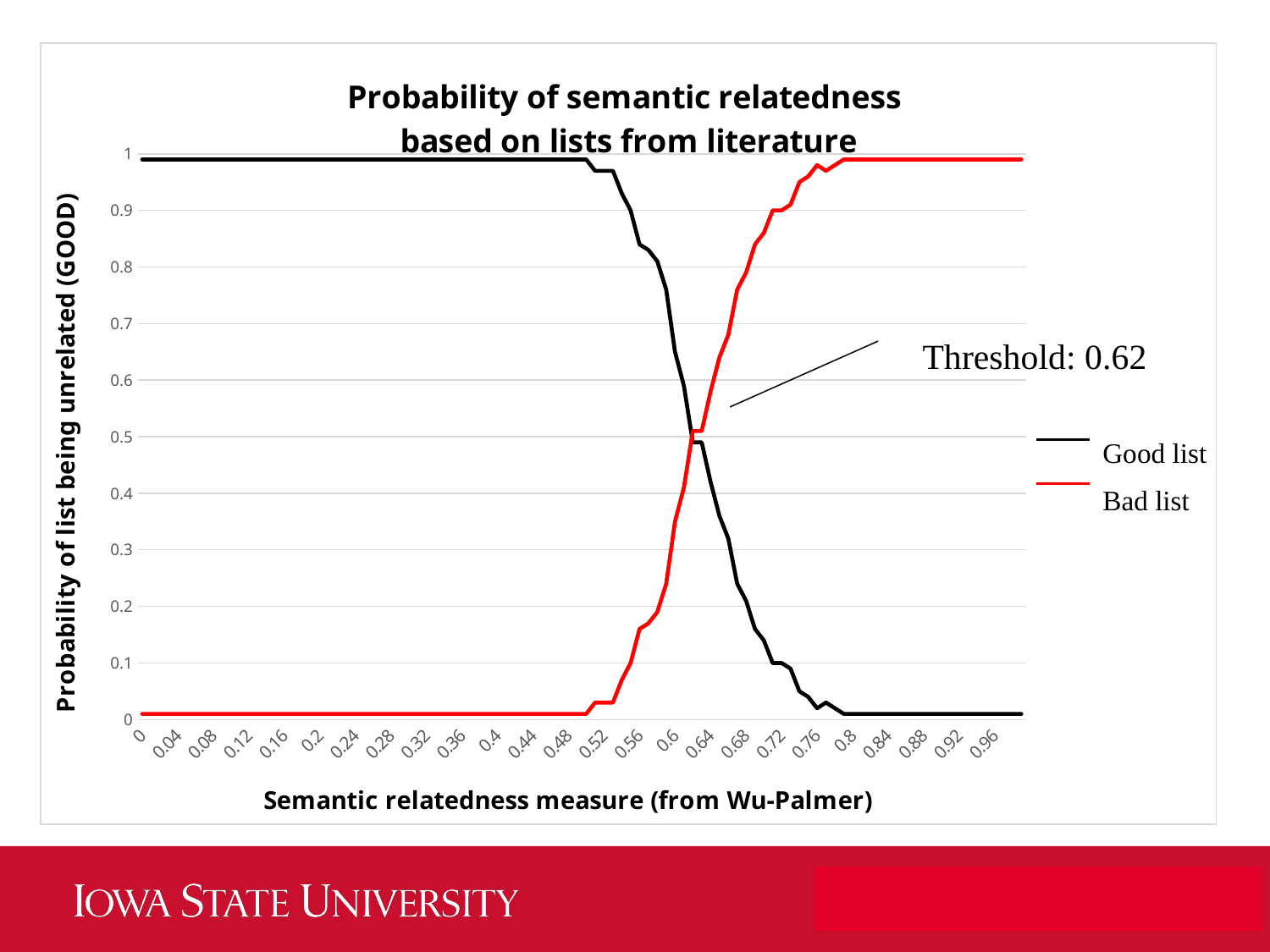
What is the title of the chart? Probability of semantic relatedness based on lists from literature Does the Bad list series rise or fall as the semantic relatedness measure increases along the x axis? Rise At a semantic relatedness measure of 0.9, which series has the higher value, Good list or Bad list? Bad list How many series does the legend list? 2 Is the value of the Bad list series at a semantic relatedness measure of 0.88 greater or less than 0.9? greater Is the value of the Good list series at a semantic relatedness measure of 0.2 greater or less than 0.9? greater Is the value of the Good list series at a semantic relatedness measure of 0.88 greater or less than 0.1? less What threshold value is annotated on the chart? 0.62 Does the Good list series rise or fall as the semantic relatedness measure increases along the x axis? Fall What kind of chart is shown on the slide? Line chart At a semantic relatedness measure of 0.2, which series has the higher value, Good list or Bad list? Good list